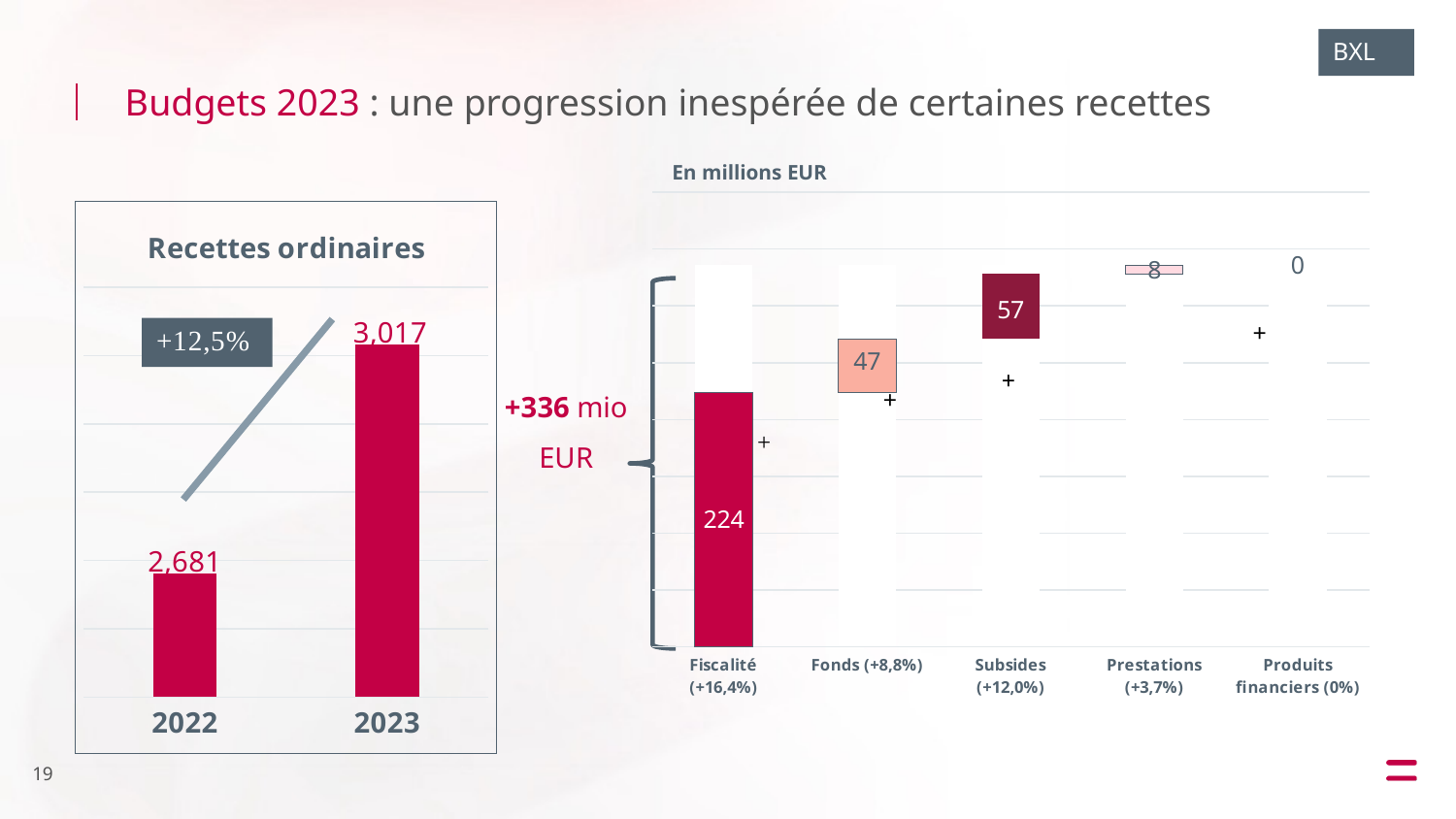
In the 'En millions EUR' chart on the right, which category has the highest value? Fiscalité In the 'Recettes ordinaires' chart, which year has the higher value? 2023 In the 'En millions EUR' chart on the right, what is the value for Fiscalité? 224 In the 'En millions EUR' chart on the right, what is the value for Subsides? 57 In the 'Recettes ordinaires' chart, what is the value for 2023? 3,017 In the 'Recettes ordinaires' chart, what is the difference between the 2023 and 2022 values? 336 In the 'Recettes ordinaires' chart, how many bars are plotted? 2 In the 'Recettes ordinaires' chart, what percentage change is shown between 2022 and 2023? +12,5% In the 'Recettes ordinaires' chart, what is the value for 2022? 2,681 In the 'En millions EUR' chart on the right, what is the value for Fonds? 47 In the 'En millions EUR' chart on the right, how many categories are shown on the x axis? 5 In the 'En millions EUR' chart on the right, which category has the lowest value? Produits financiers